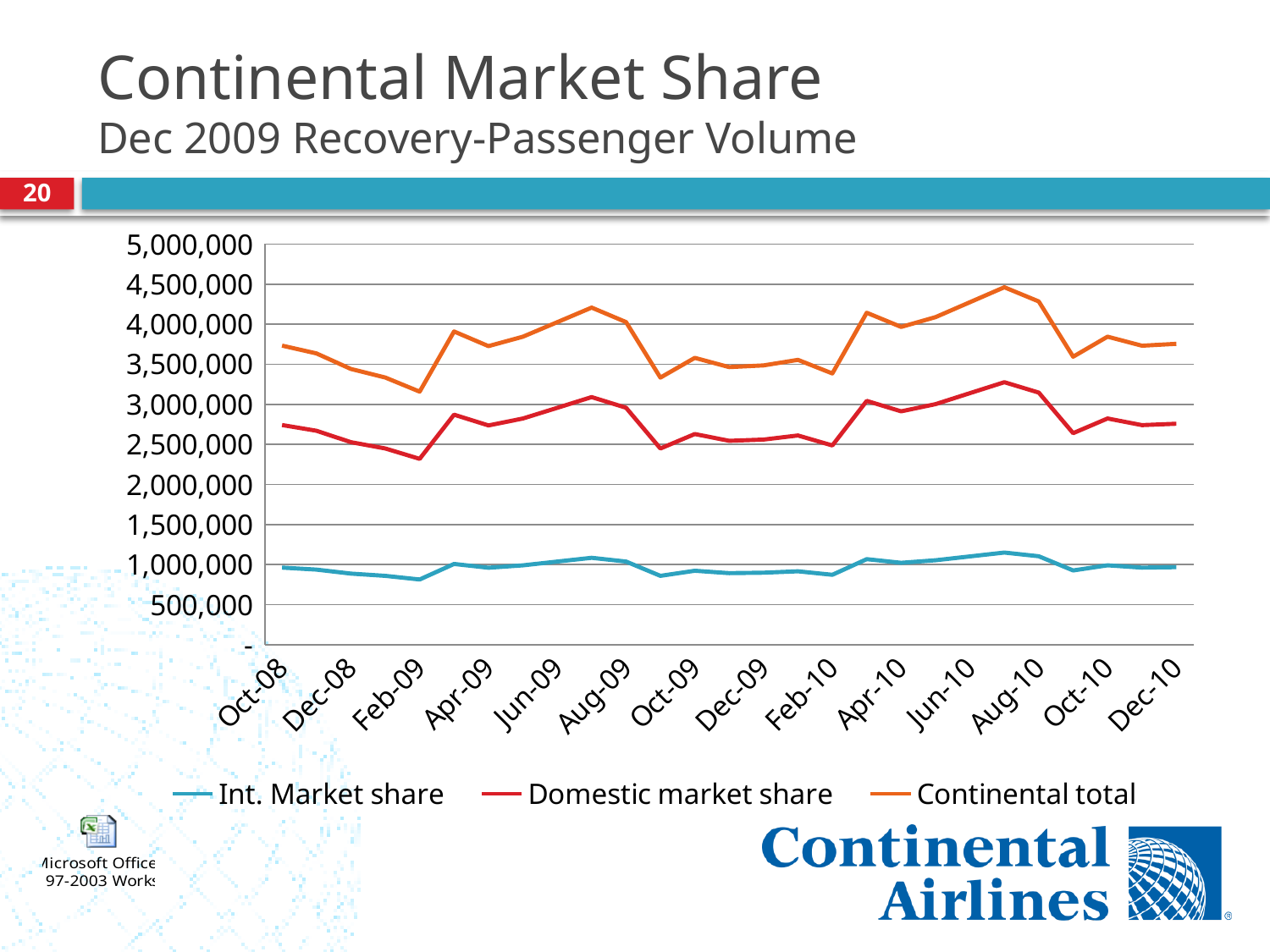
Is the value for Domestic market share at Aug-10 greater or less than 3,000,000? greater Is the value for Continental total at Oct-08 greater or less than 3,500,000? greater Which series has the highest values across the whole chart? Continental total What kind of chart is shown on the slide? line chart How many series does the legend list? 3 Is the value for Domestic market share at Feb-09 greater or less than 2,500,000? less What are the three series named in the legend? Int. Market share, Domestic market share, Continental total At Jun-10, which is larger: Continental total or Domestic market share? Continental total What is the highest value shown on the y axis? 5,000,000 At which labeled month does Continental total reach its lowest value? Feb-09 Does Continental total rise or fall from Oct-08 to Feb-09? fall